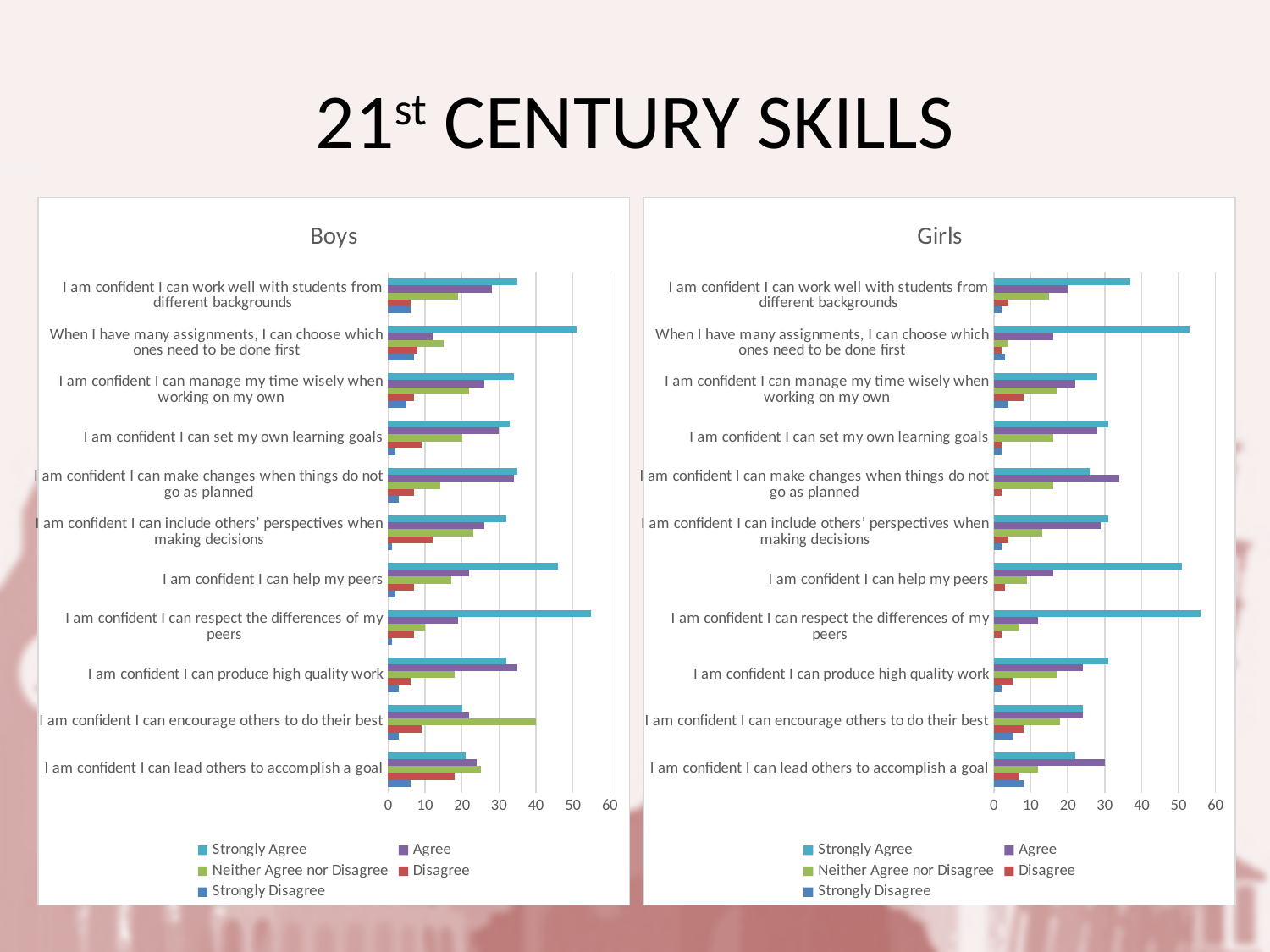
In the Boys chart, which is larger: the Strongly Agree value for "I am confident I can respect the differences of my peers" or the Strongly Agree value for "I am confident I can lead others to accomplish a goal"? I am confident I can respect the differences of my peers What is the title of the chart on the right side of the slide? Girls What kind of chart is the Boys chart? bar chart How many series does the legend of the Boys chart list? 5 In the Boys chart, is the Strongly Agree value for "I am confident I can respect the differences of my peers" greater or less than 50? greater In the Boys chart, is the Strongly Agree value for "I am confident I can help my peers" greater or less than 40? greater In the Girls chart, is the Strongly Agree value for "When I have many assignments, I can choose which ones need to be done first" greater or less than 40? greater How many statements (categories) are listed on the Girls chart? 11 In the Boys chart, which response has the highest value for "I am confident I can encourage others to do their best"? Neither Agree nor Disagree In the Girls chart, for "I am confident I can make changes when things do not go as planned", which is larger: Agree or Strongly Agree? Agree